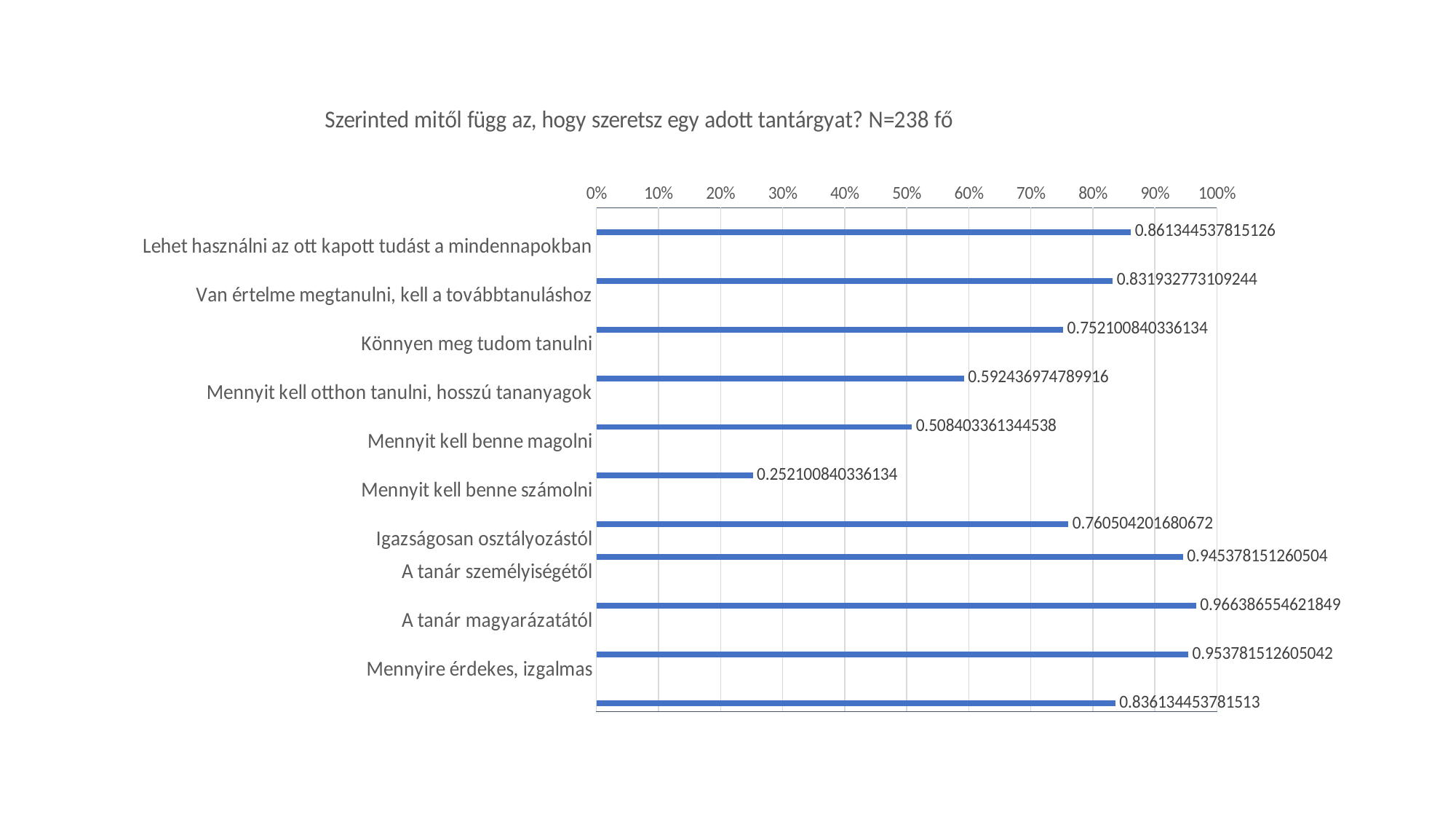
What is the difference between the highest value (0.966386554621849) and the lowest value (0.252100840336134)? 0.714285714285715 What is the value for 'A tanár magyarázatától'? 0.966386554621849 Which is larger: the value for 'Lehet használni az ott kapott tudást a mindennapokban' or for 'Van értelme megtanulni, kell a továbbtanuláshoz'? Lehet használni az ott kapott tudást a mindennapokban What is the title of the chart? Szerinted mitől függ az, hogy szeretsz egy adott tantárgyat? N=238 fő What is the value for 'Könnyen meg tudom tanulni'? 0.752100840336134 Which category has the lowest value? Mennyit kell benne számolni How many bars are plotted in the chart? 11 Is the value for 'Mennyit kell otthon tanulni, hosszú tananyagok' greater or less than 50%? greater What is the value for 'Mennyit kell benne magolni'? 0.508403361344538 What kind of chart is shown on the slide? bar chart What is the value for 'Mennyit kell benne számolni'? 0.252100840336134 Which category has the highest value? A tanár magyarázatától